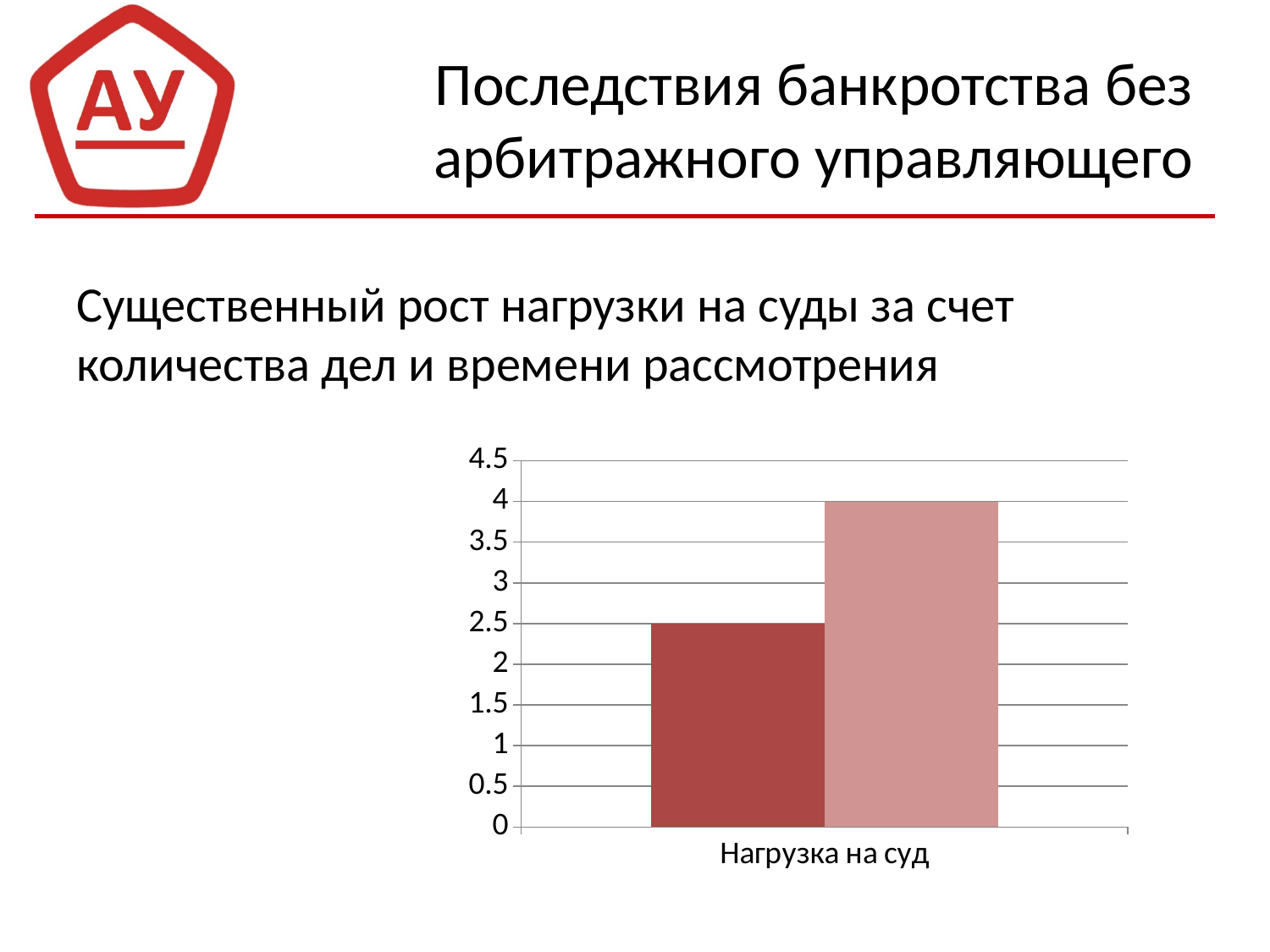
How many categories are shown on the x axis of the chart? 1 Which bar has the lowest value in the chart? the dark red (left) bar What is the category label on the x axis of the chart? Нагрузка на суд Is the value of the light pink (right) bar greater or less than 3? greater Is the value of the dark red (left) bar greater or less than 3? less What is the value of the dark red (left) bar for Нагрузка на суд? 2.5 What kind of chart is shown on the slide? bar chart How many bars are plotted in the chart? 2 What is the highest value shown on the y axis of the chart? 4.5 What is the difference between the light pink (right) bar and the dark red (left) bar? 1.5 What is the value of the light pink (right) bar for Нагрузка на суд? 4 Which bar is taller, the dark red (left) bar or the light pink (right) bar? the light pink (right) bar